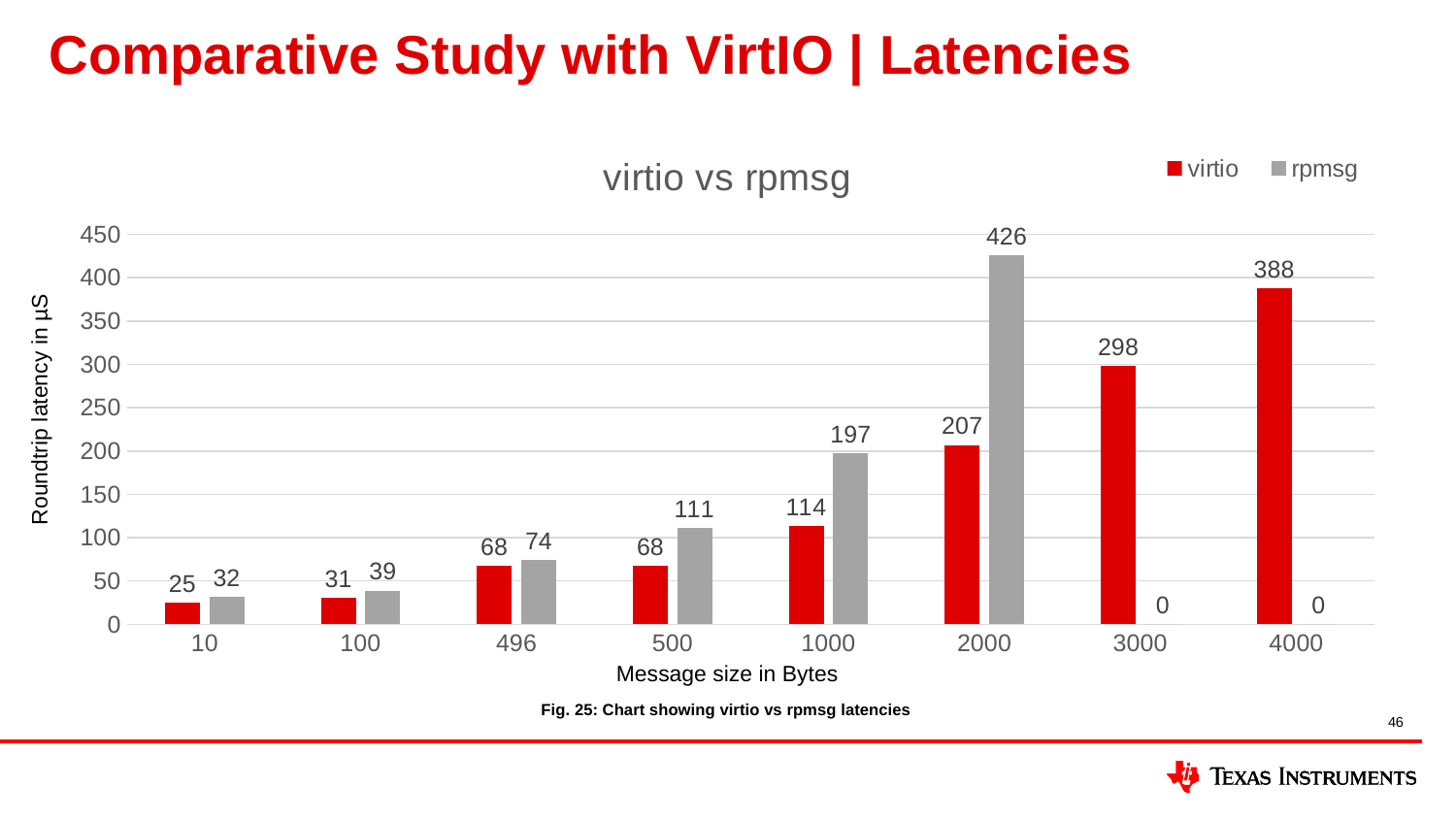
Which message size has the highest rpmsg latency? 2000 Does the virtio latency rise or fall as message size increases along the x axis? rise At a message size of 2000 bytes, which series has the higher latency, virtio or rpmsg? rpmsg Which message size has the lowest virtio latency? 10 How many series does the legend list? 2 What is the rpmsg roundtrip latency for a message size of 2000 bytes? 426 How many message size categories are shown on the x axis? 8 What is the virtio roundtrip latency for a message size of 1000 bytes? 114 What is the virtio latency for a message size of 4000 bytes? 388 What kind of chart is shown on the slide? bar chart What is the title of the chart? virtio vs rpmsg What is the difference between the rpmsg and virtio latencies at a message size of 500 bytes? 43